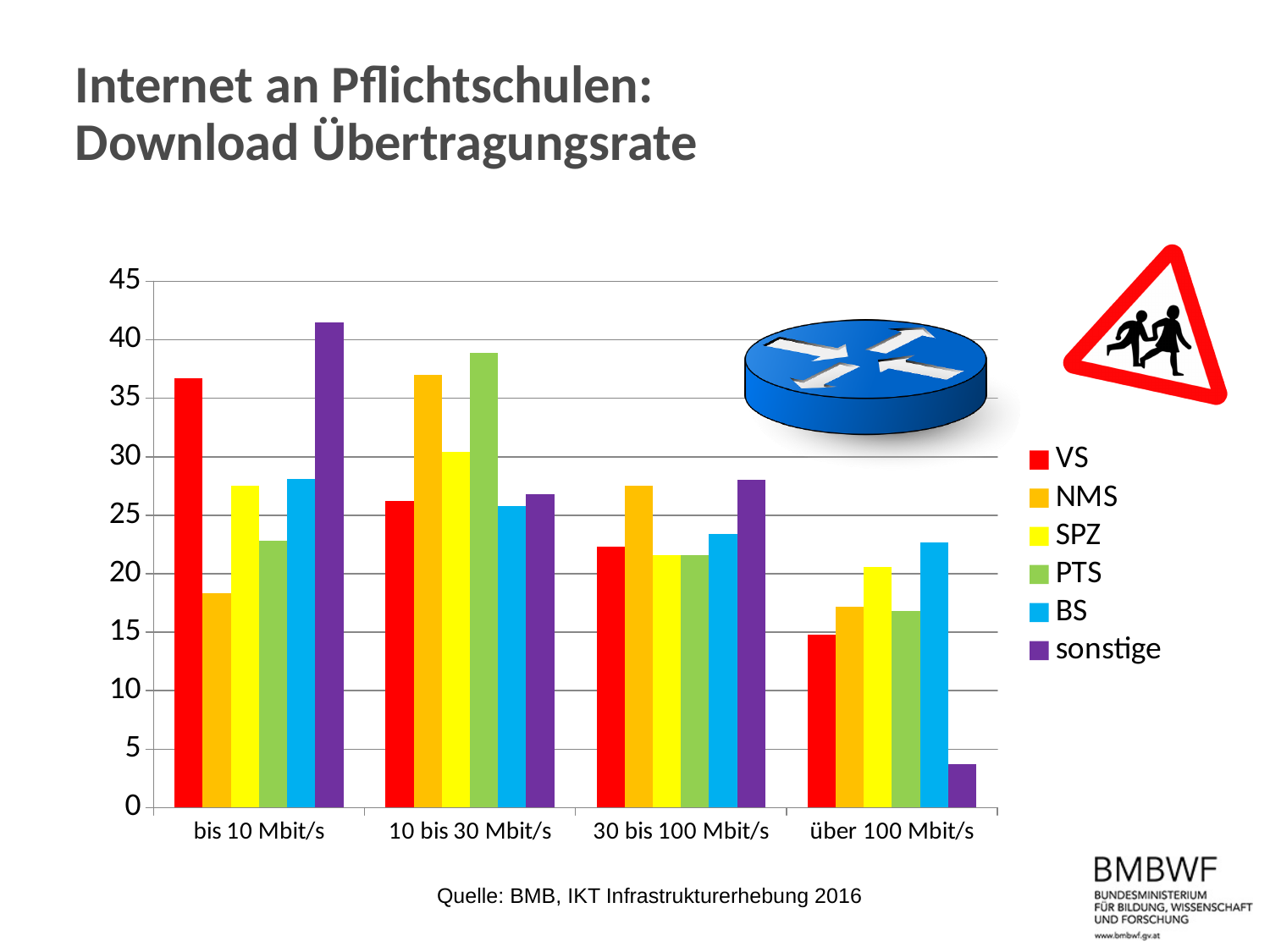
How many categories are shown on the x axis? 4 Is the value for NMS in the 'bis 10 Mbit/s' category greater or less than 20? less In the 'über 100 Mbit/s' category, which series has the lowest value? sonstige Do the values for VS rise or fall from 'bis 10 Mbit/s' to 'über 100 Mbit/s'? fall Is the value for VS in the 'bis 10 Mbit/s' category greater or less than 35? greater What kind of chart is shown on the slide? bar chart In the 'bis 10 Mbit/s' category, which series has the highest value? sonstige How many series does the legend list? 6 In the 'über 100 Mbit/s' category, which is larger: the value for SPZ or the value for BS? BS Which colour represents the VS series in the legend? red Is the value for sonstige in the 'über 100 Mbit/s' category greater or less than 5? less In the '10 bis 30 Mbit/s' category, which series has the highest value? PTS